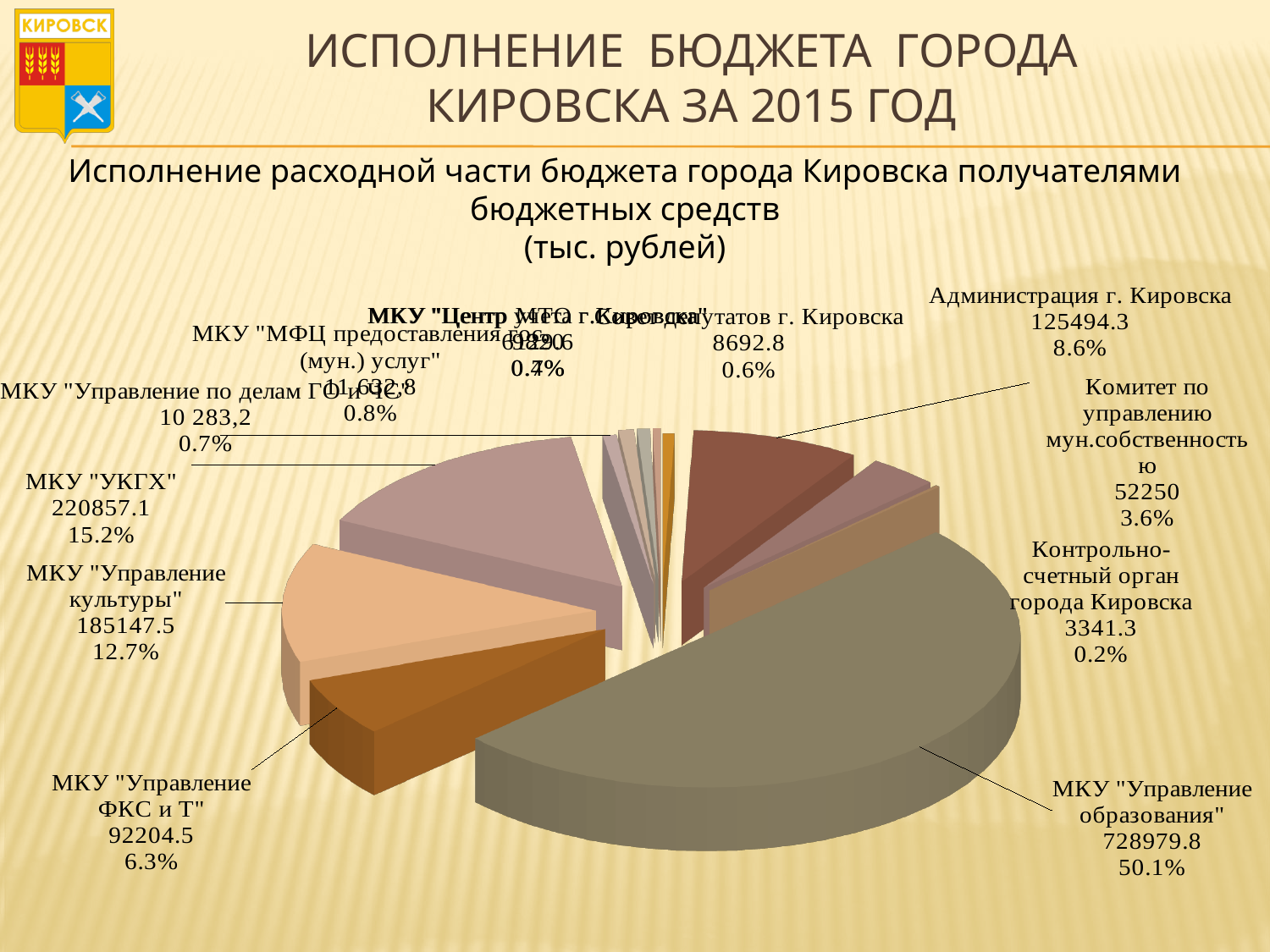
What is the value for МКУ "Управление образования"? 728979.8 What share of the pie does МКУ "Управление образования" take? 50.1% What share of the pie does МКУ "Управление ФКС и Т" take? 6.3% What is the difference between the values for МКУ "УКГХ" and МКУ "Управление культуры"? 35709.6 Which is larger, the value for МКУ "УКГХ" or for МКУ "Управление культуры"? МКУ "УКГХ" What kind of chart is shown on the slide? pie chart In what units are the values in the chart given, according to the chart title? тыс. рублей What is the value for Администрация г. Кировска? 125494.3 What share of the pie does МКУ "УКГХ" take? 15.2% Which recipient has the largest slice of the pie? МКУ "Управление образования" Which recipient has the smallest share of the pie? Контрольно-счетный орган города Кировска What is the value for Комитет по управлению мун.собственностью? 52250